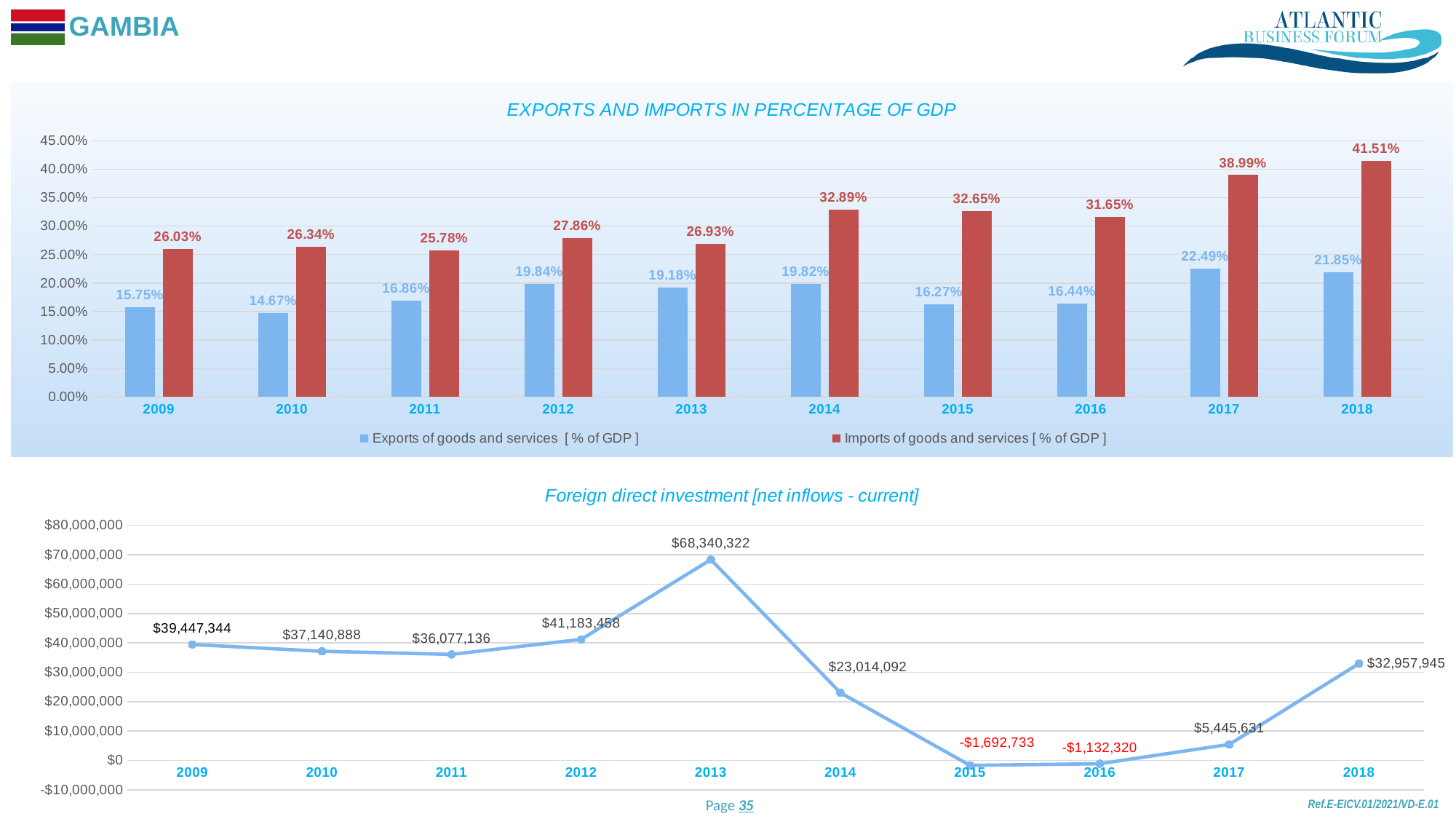
In the 'Exports and Imports in Percentage of GDP' chart, what is the value of imports of goods and services in 2018? 41.51% In the 'Exports and Imports in Percentage of GDP' chart, which year has the highest exports value? 2017 In the 'Exports and Imports in Percentage of GDP' chart, which year has the lowest imports value? 2011 What kind of chart is the 'Exports and Imports in Percentage of GDP' chart? Bar chart In the 'Foreign direct investment [net inflows - current]' chart, which year has the lowest value? 2015 In the 'Foreign direct investment [net inflows - current]' chart, which is larger, the value for 2009 or the value for 2018? 2009 In the 'Exports and Imports in Percentage of GDP' chart, what is the difference between imports and exports in 2018? 19.66% In the 'Foreign direct investment [net inflows - current]' chart, what is the value for 2013? $68,340,322 In the 'Foreign direct investment [net inflows - current]' chart, how many years are plotted? 10 In the 'Exports and Imports in Percentage of GDP' chart, what is the value of exports of goods and services in 2010? 14.67% In the 'Exports and Imports in Percentage of GDP' chart, how many series does the legend list? 2 What kind of chart is the 'Foreign direct investment [net inflows - current]' chart? Line chart